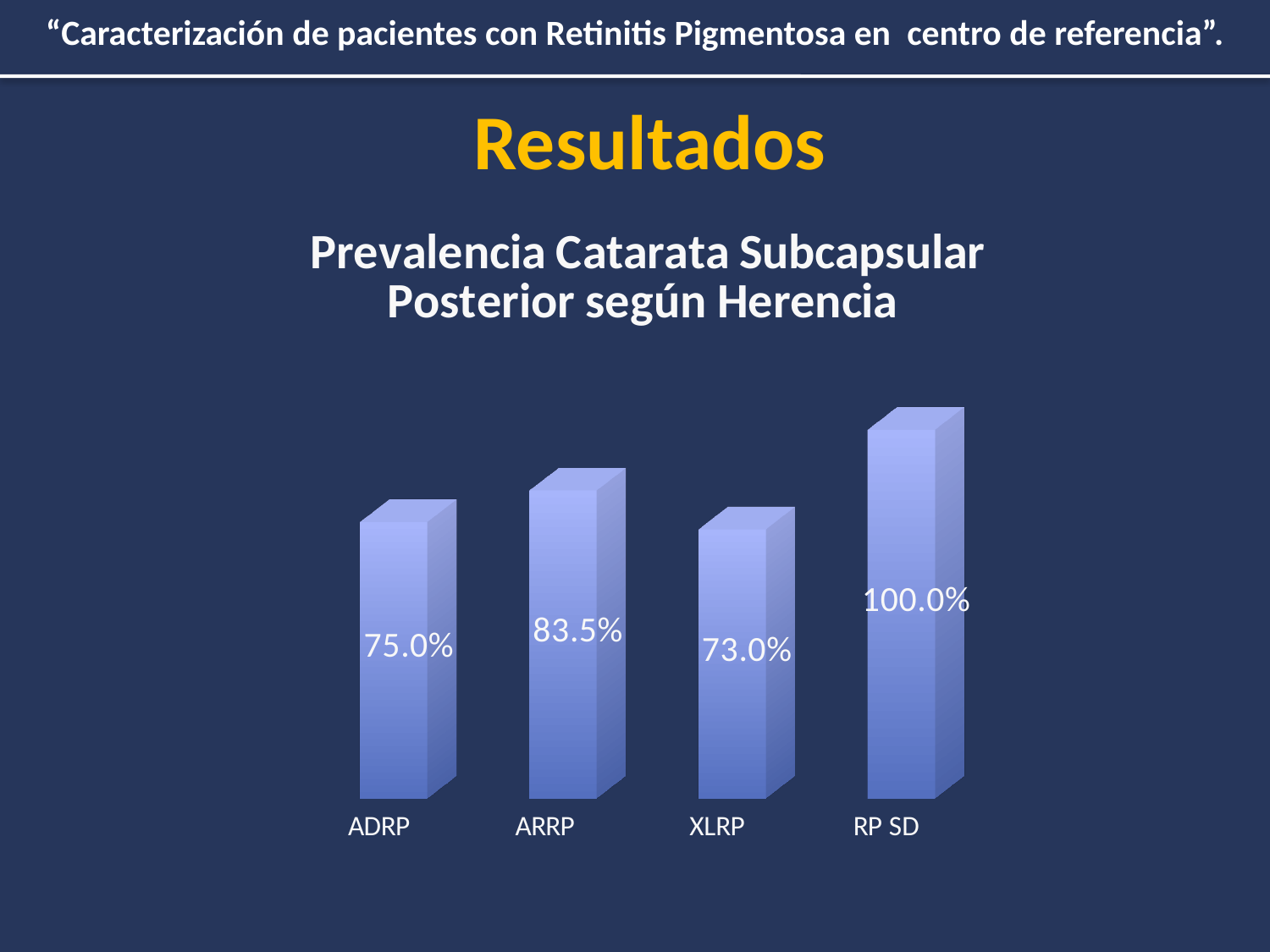
What is the value for ARRP? 83.5% How many categories are shown in the chart? 4 Which category has the highest value? RP SD Which is larger, the value for ARRP or the value for ADRP? ARRP What is the value for XLRP? 73.0% What is the title of the chart? Prevalencia Catarata Subcapsular Posterior según Herencia What is the value for ADRP? 75.0% What is the difference between the values for ARRP and XLRP? 10.5% What kind of chart is shown on the slide? Bar chart What is the difference between the values for RP SD and ADRP? 25.0% What is the value for RP SD? 100.0% Which category has the lowest value? XLRP